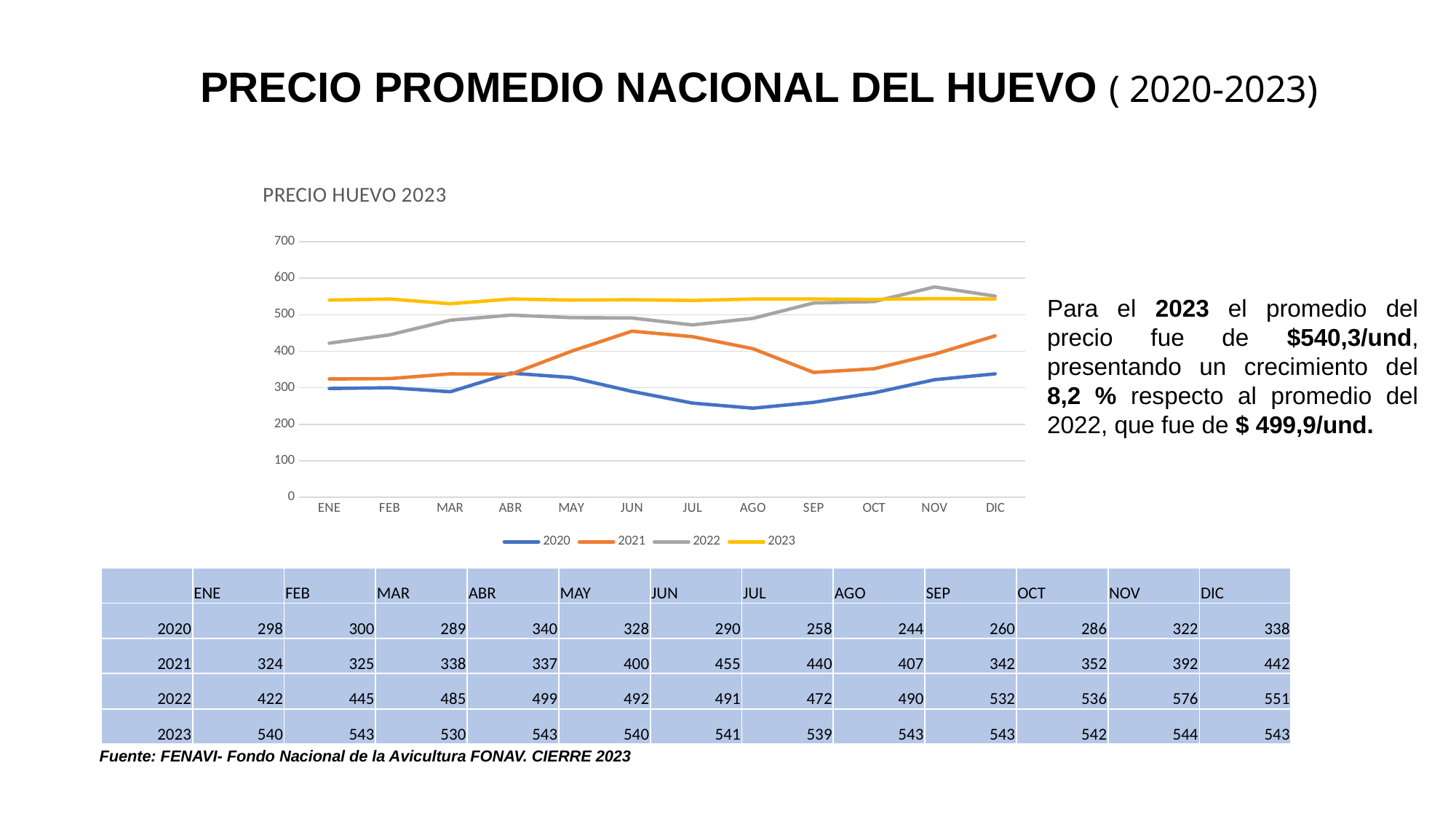
Which series has the higher value in ABR, 2020 or 2021? 2020 What kind of chart is shown on the slide? line chart What is the difference between the 2023 and 2022 values in ENE? 118 How many months are plotted along the x axis of the chart? 12 In which month does the 2022 series reach its highest value? NOV What is the value for the 2021 series in JUN? 455 What is the value for the 2022 series in NOV? 576 In which month does the 2020 series reach its lowest value? AGO What is the title of the chart? PRECIO HUEVO 2023 Is the value for the 2021 series in SEP greater or less than 400? less What is the value for the 2020 series in AGO? 244 How many series does the chart legend list? 4